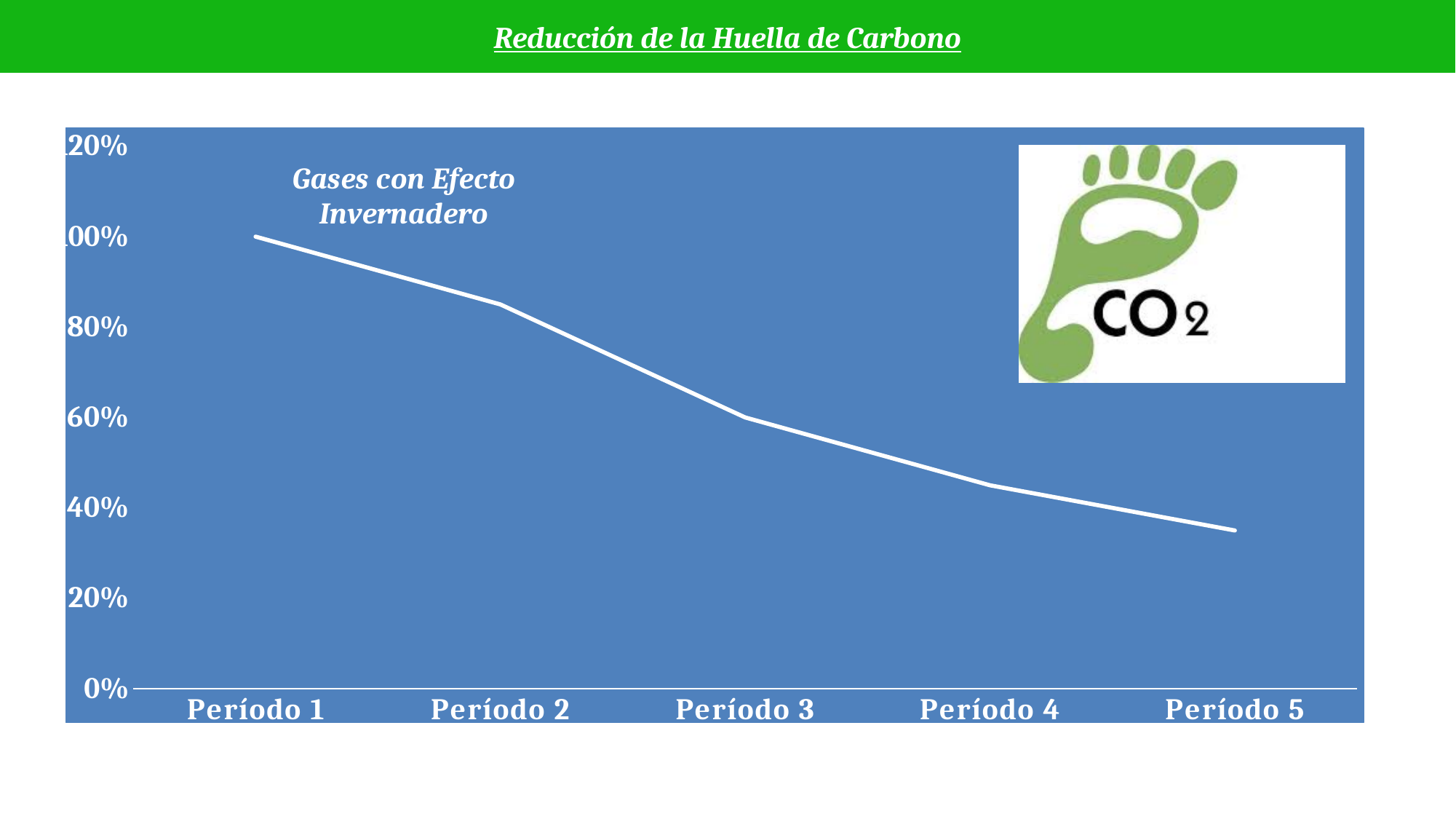
Is the value for Período 5 greater or less than 40%? less What kind of chart is shown on the slide? line chart Do the values in the chart rise or fall from Período 1 to Período 5? fall Which is larger, the value for Período 2 or the value for Período 4? Período 2 Which period has the highest value in the chart? Período 1 Is the value for Período 2 greater or less than 80%? greater What label is written above the line in the chart? Gases con Efecto Invernadero How many periods are plotted along the x axis of the chart? 5 Is the value for Período 3 greater or less than 80%? less What is the title shown at the top of the slide? Reducción de la Huella de Carbono Which period has the lowest value in the chart? Período 5